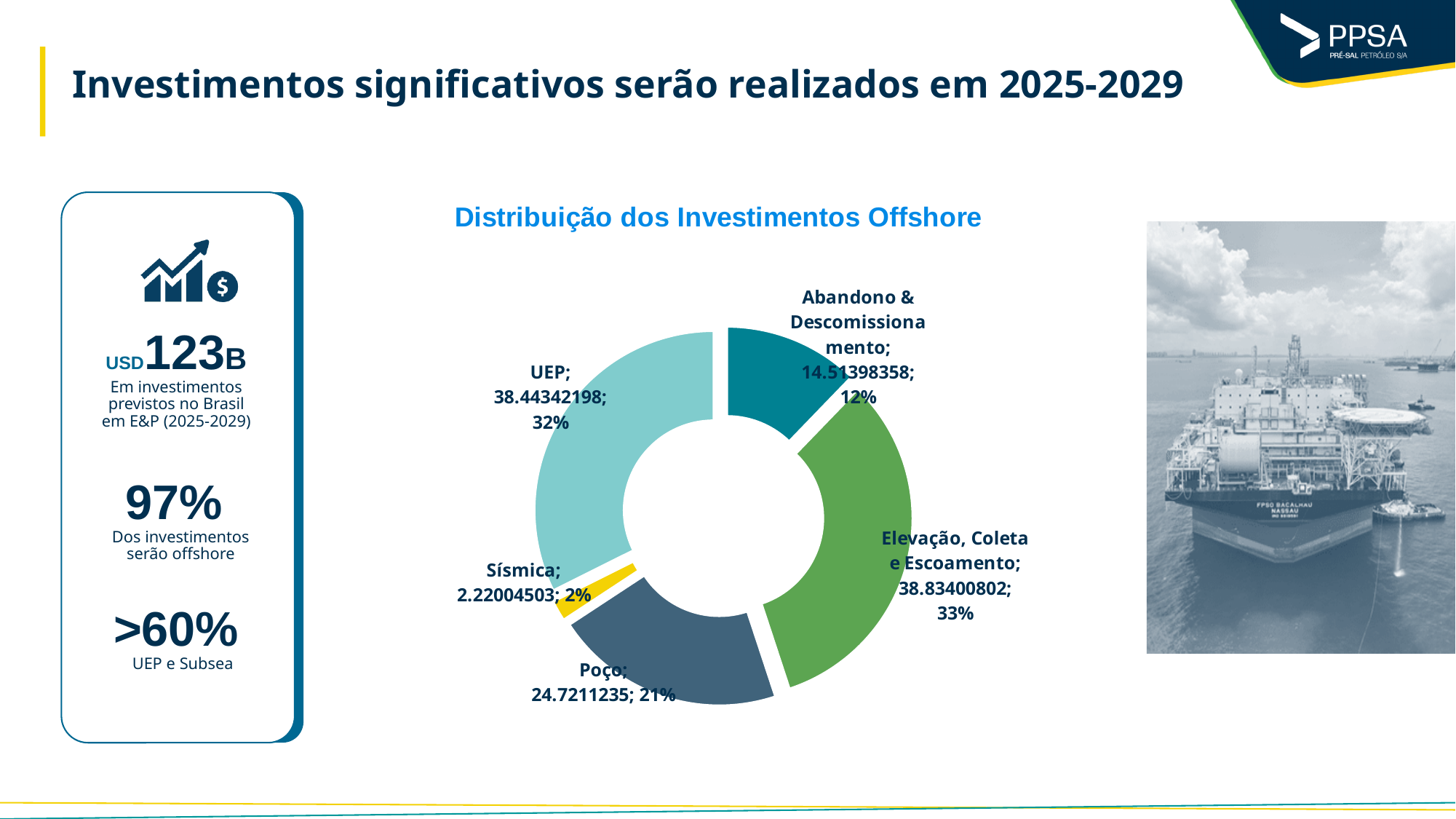
What value is shown for Poço in the pie chart? 24.7211235 What percentage share does Abandono & Descomissionamento have? 12% What percentage share does UEP have in the pie chart? 32% Which category has the smallest share of the pie chart? Sísmica What is the title of the chart? Distribuição dos Investimentos Offshore Which is larger, the share for Poço or the share for Abandono & Descomissionamento? Poço How many slices does the pie chart have? 5 What value is shown for Elevação, Coleta e Escoamento in the pie chart? 38.83400802 What kind of chart is shown on the slide? Pie chart (donut) What value is shown for Sísmica in the pie chart? 2.22004503 Which category has the largest share of the pie chart? Elevação, Coleta e Escoamento What is the difference in percentage points between the share for UEP and the share for Poço? 11